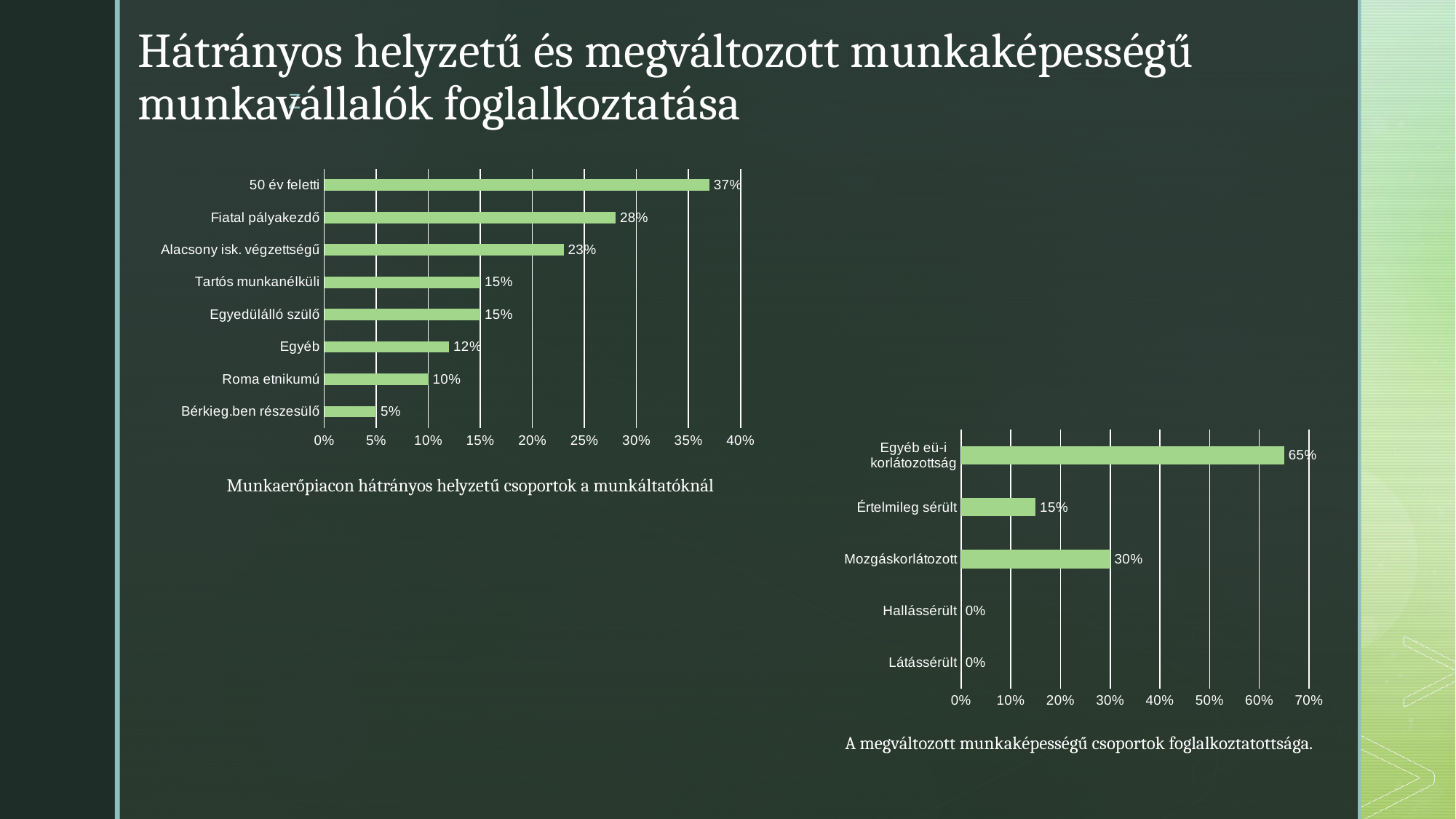
In the right chart (A megváltozott munkaképességű csoportok foglalkoztatottsága), which category has the highest value? Egyéb eü-i korlátozottság In the left chart (Munkaerőpiacon hátrányos helyzetű csoportok a munkáltatóknál), which category has the lowest value? Bérkieg.ben részesülő In the left chart (Munkaerőpiacon hátrányos helyzetű csoportok a munkáltatóknál), what is the value for Roma etnikumú? 10% In the right chart (A megváltozott munkaképességű csoportok foglalkoztatottsága), what is the value for Hallássérült? 0% In the right chart (A megváltozott munkaképességű csoportok foglalkoztatottsága), what is the difference between Egyéb eü-i korlátozottság and Értelmileg sérült? 50% In the right chart (A megváltozott munkaképességű csoportok foglalkoztatottsága), what is the value for Mozgáskorlátozott? 30% How many categories are shown in the right chart (A megváltozott munkaképességű csoportok foglalkoztatottsága)? 5 In the left chart (Munkaerőpiacon hátrányos helyzetű csoportok a munkáltatóknál), what is the value for 50 év feletti? 37% How many categories are shown in the left chart (Munkaerőpiacon hátrányos helyzetű csoportok a munkáltatóknál)? 8 What type of chart is the right chart (A megváltozott munkaképességű csoportok foglalkoztatottsága)? Bar chart In the left chart (Munkaerőpiacon hátrányos helyzetű csoportok a munkáltatóknál), what is the difference between Fiatal pályakezdő and Alacsony isk. végzettségű? 5% In the left chart (Munkaerőpiacon hátrányos helyzetű csoportok a munkáltatóknál), which is larger: Egyéb or Tartós munkanélküli? Tartós munkanélküli